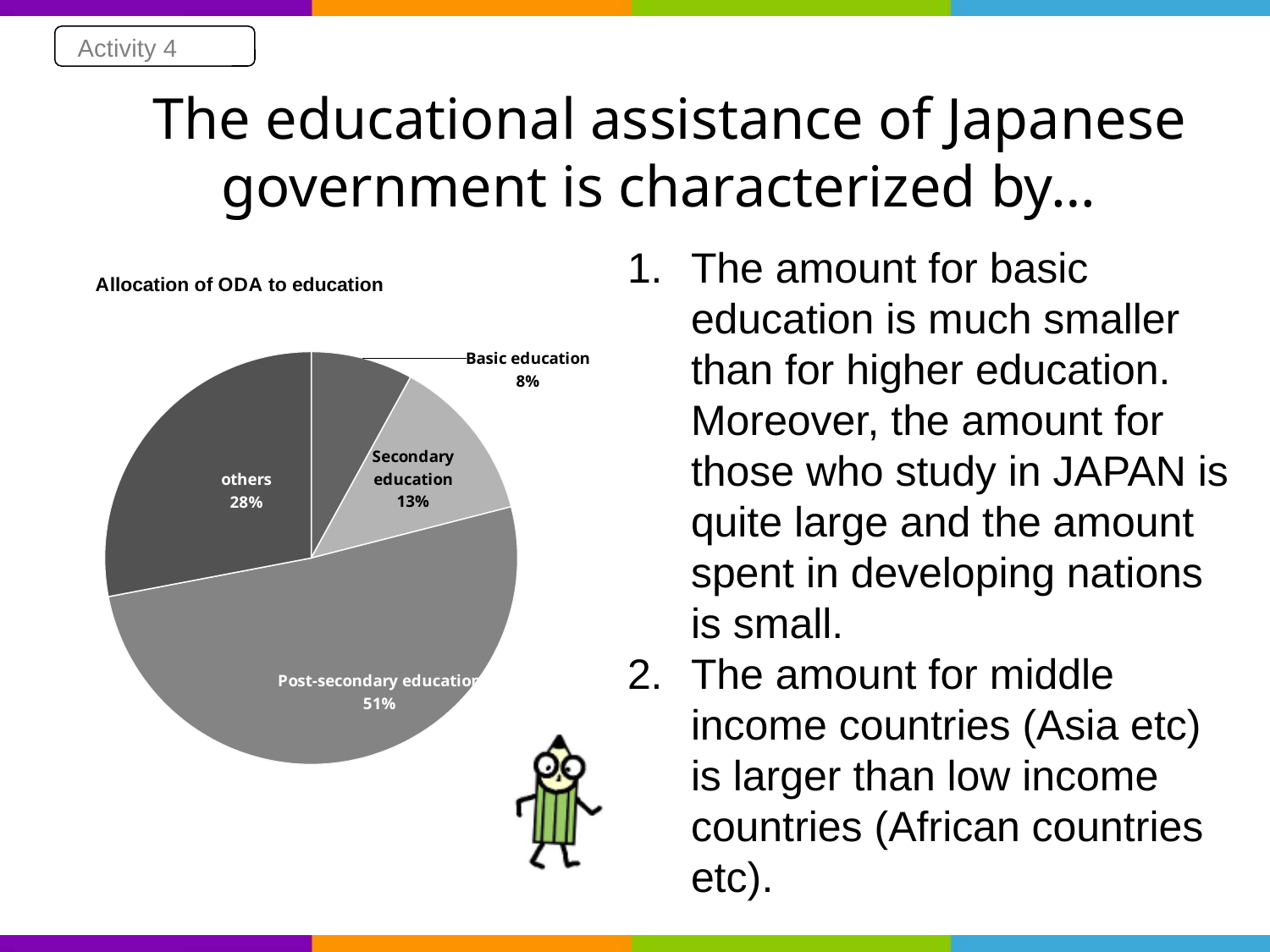
What is the title of the chart? Allocation of ODA to education What share of ODA to education goes to Basic education? 8% Which is larger, the share for Secondary education or the share for others? others What is the combined share of Basic education and Secondary education? 21% Which category receives the smallest share of ODA to education? Basic education What share of ODA to education goes to others? 28% What is the difference in percentage points between Post-secondary education and Basic education? 43 What share of ODA to education goes to Secondary education? 13% What share of ODA to education goes to Post-secondary education? 51% What kind of chart is shown on the slide? pie chart Which category receives the largest share of ODA to education? Post-secondary education How many slices does the pie chart have? 4